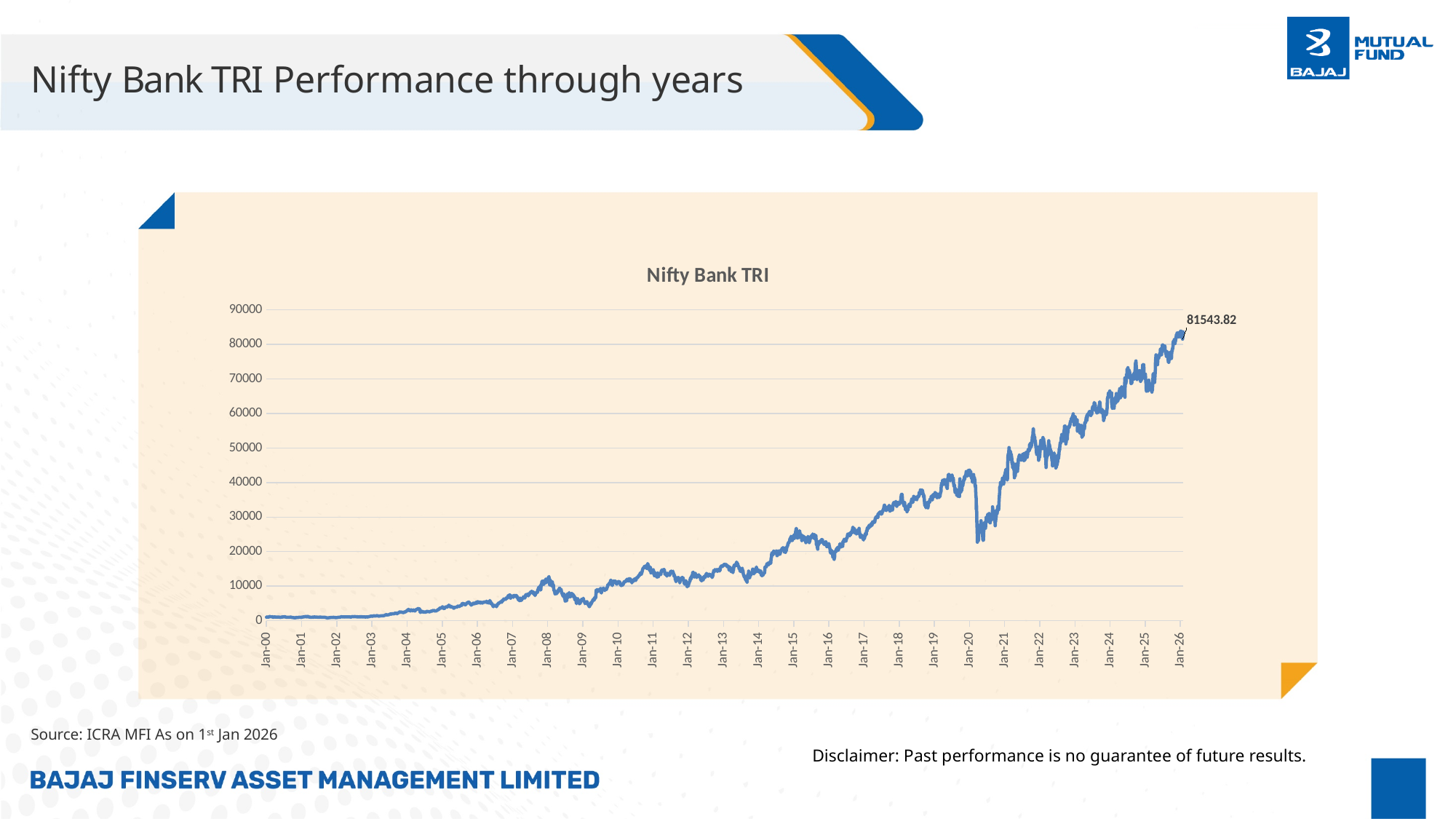
At which x-axis label does the Nifty Bank TRI line reach its highest value? Jan-26 Which is higher, the Nifty Bank TRI value at Jan-15 or at Jan-16? Jan-15 Is the value of Nifty Bank TRI at Jan-15 greater or less than 20000? greater Which is higher, the Nifty Bank TRI value at Jan-08 or at Jan-09? Jan-08 Overall, does the Nifty Bank TRI line rise or fall from Jan-00 to Jan-26? rise Is the value of Nifty Bank TRI at Jan-05 greater or less than 10000? less How many year labels are shown on the x axis of the chart? 27 What kind of chart is shown on the slide? line chart What is the title of the chart? Nifty Bank TRI What is the value printed at the end of the Nifty Bank TRI line (Jan-26)? 81543.82 Is the value of Nifty Bank TRI at Jan-26 greater or less than 80000? greater